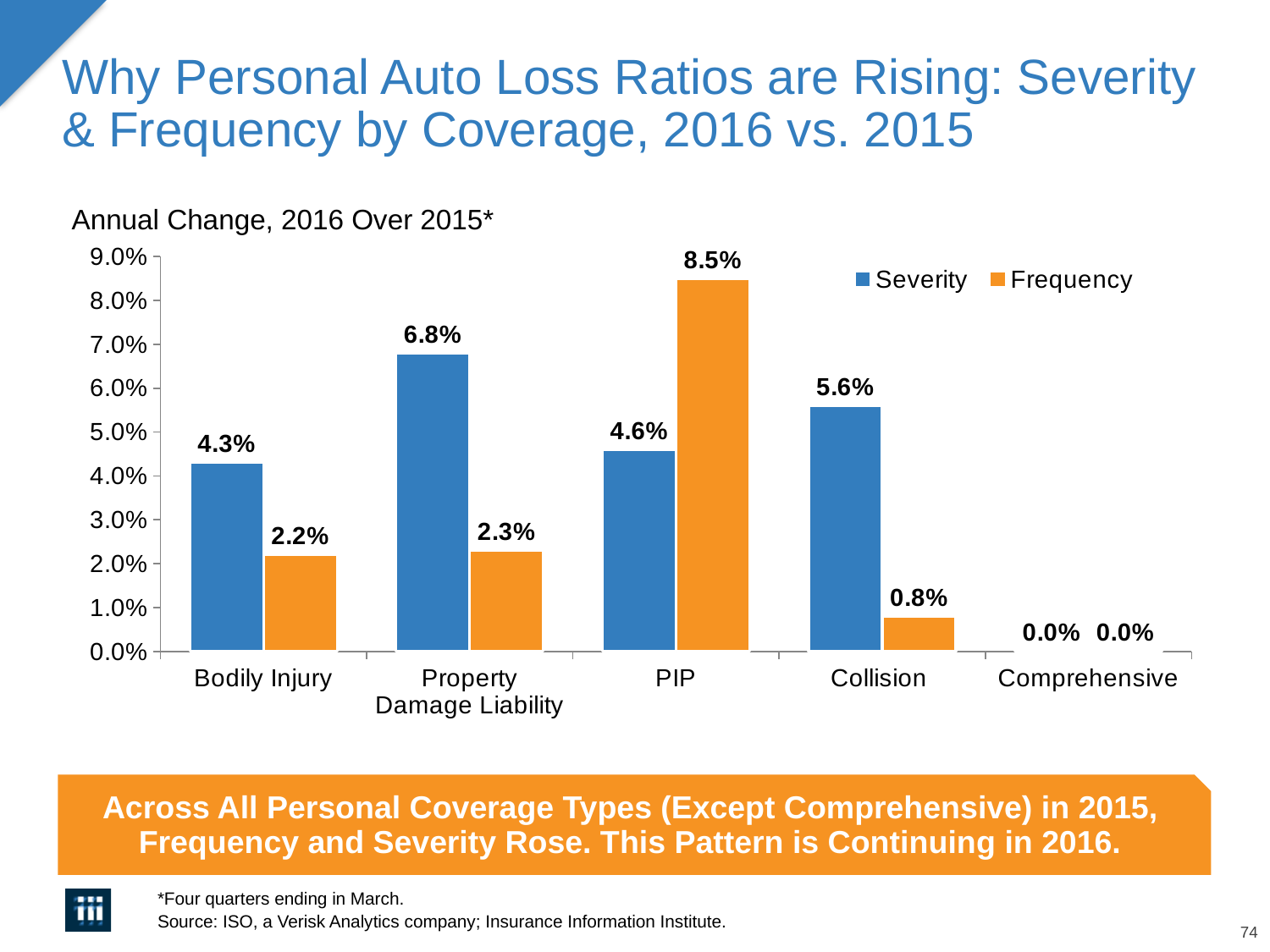
Which is larger for Property Damage Liability, Severity or Frequency? Severity What is the Severity value for Bodily Injury? 4.3% How many series does the legend list? 2 What is the difference between the Frequency value for PIP and the Frequency value for Bodily Injury? 6.3% What kind of chart is shown on the slide? Bar chart What is the Frequency value for PIP? 8.5% Which coverage has the highest Severity value? Property Damage Liability How many coverage categories are shown on the x axis? 5 What is the Frequency value for Collision? 0.8% Which is larger for PIP, Severity or Frequency? Frequency What is the difference between the Severity and Frequency values for Collision? 4.8% Which coverage has the highest Frequency value? PIP